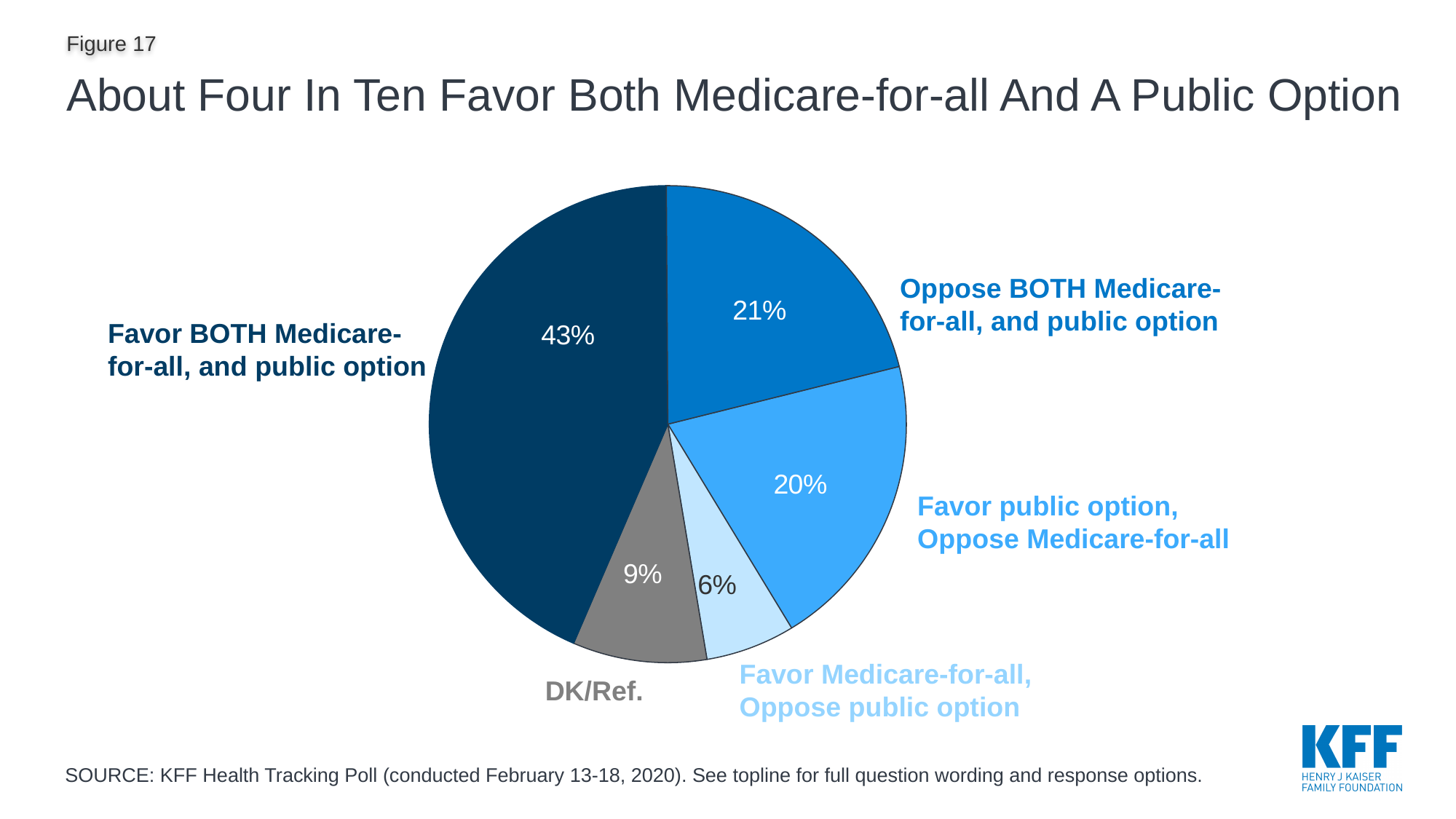
What is the title of the slide? About Four In Ten Favor Both Medicare-for-all And A Public Option What percentage favor a public option but oppose Medicare-for-all? 20% Which is larger: the share that oppose both, or the share that favor a public option but oppose Medicare-for-all? Oppose BOTH Medicare-for-all, and public option Which category has the largest slice of the pie? Favor BOTH Medicare-for-all, and public option What percentage favor Medicare-for-all but oppose a public option? 6% What is the value for the DK/Ref. slice? 9% How many slices does the pie chart have? 5 What type of chart is shown on the slide? Pie chart Which category has the smallest slice of the pie? Favor Medicare-for-all, Oppose public option What is the difference between the share that favor both and the share that oppose both? 22 percentage points What share of respondents favor both Medicare-for-all and a public option? 43% What percentage oppose both Medicare-for-all and a public option? 21%